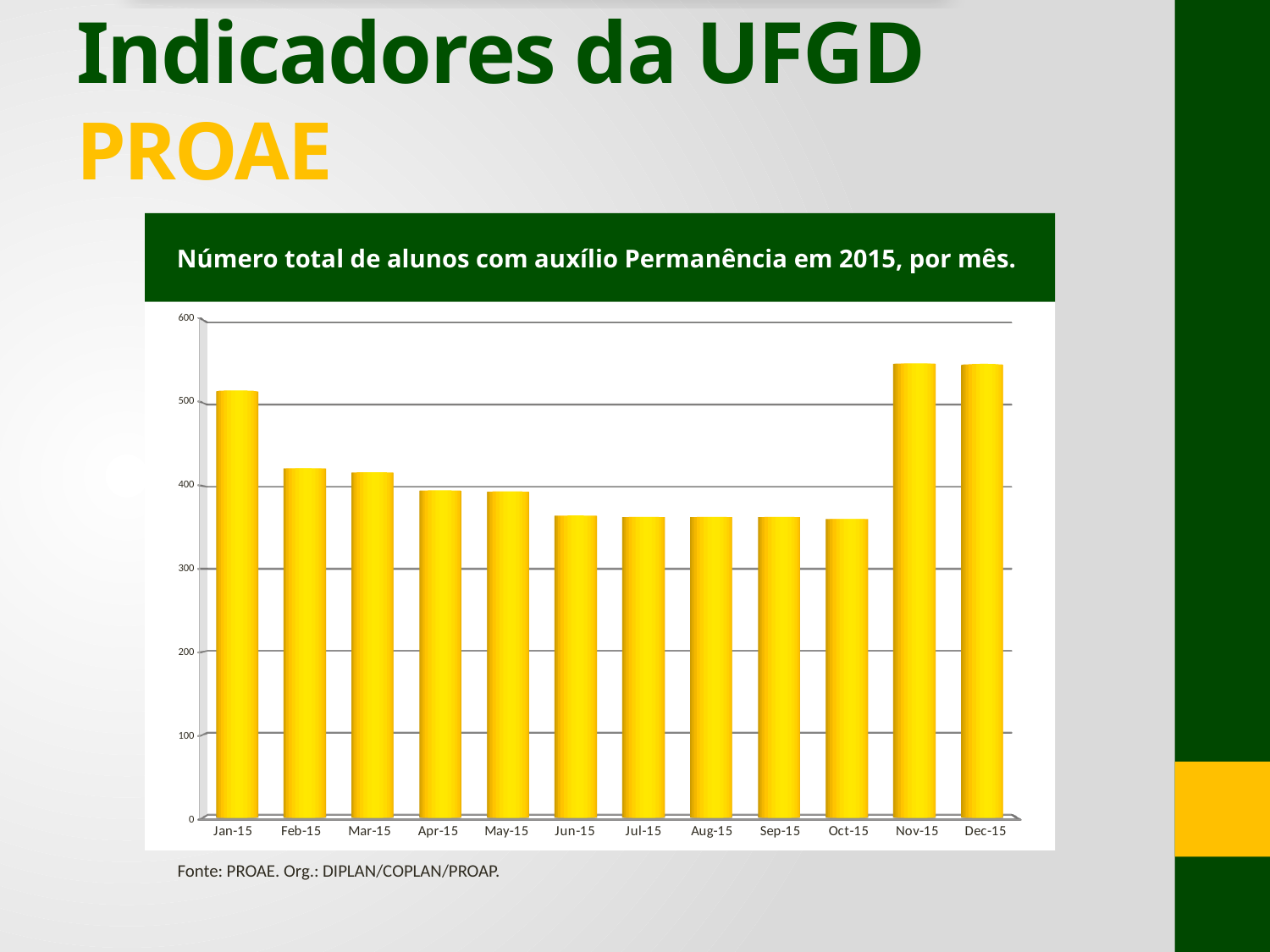
Is the value for Jan-15 greater or less than 500? greater Is the value for Feb-15 greater or less than 400? greater What kind of chart is shown on the slide? bar chart What colour are the bars in the chart? yellow Is the value for Oct-15 greater or less than 300? greater What is the title of the chart? Número total de alunos com auxílio Permanência em 2015, por mês. Do the values rise or fall from Jan-15 to Oct-15? fall Which is larger, the value for Jan-15 or the value for Feb-15? Jan-15 How many months are shown on the x axis of the chart? 12 Which is larger, the value for Jun-15 or the value for Nov-15? Nov-15